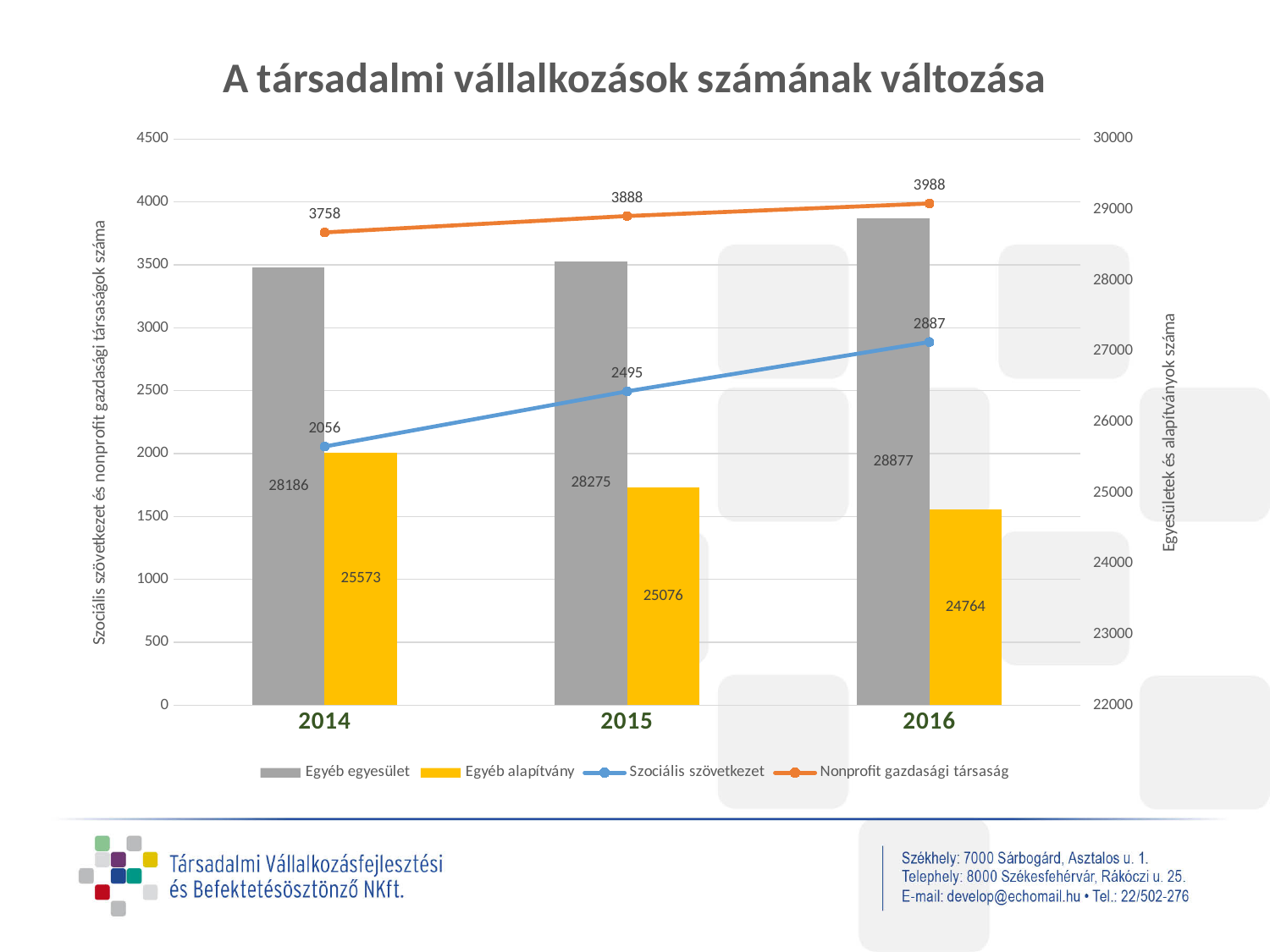
What is the value of Egyéb egyesület in 2014? 28186 How many years are shown on the x axis? 3 What is the value of Szociális szövetkezet in 2015? 2495 Which is larger: Egyéb egyesület in 2015 or Egyéb egyesület in 2016? Egyéb egyesület in 2016 What is the value of Nonprofit gazdasági társaság in 2016? 3988 What is the difference between the Nonprofit gazdasági társaság values in 2016 and 2014? 230 Does Egyéb alapítvány rise or fall from 2014 to 2016? fall In which year is Egyéb alapítvány highest? 2014 What is the value of Egyéb alapítvány in 2016? 24764 In which year is Szociális szövetkezet lowest? 2014 What is the title of the chart? A társadalmi vállalkozások számának változása How many series does the legend list? 4